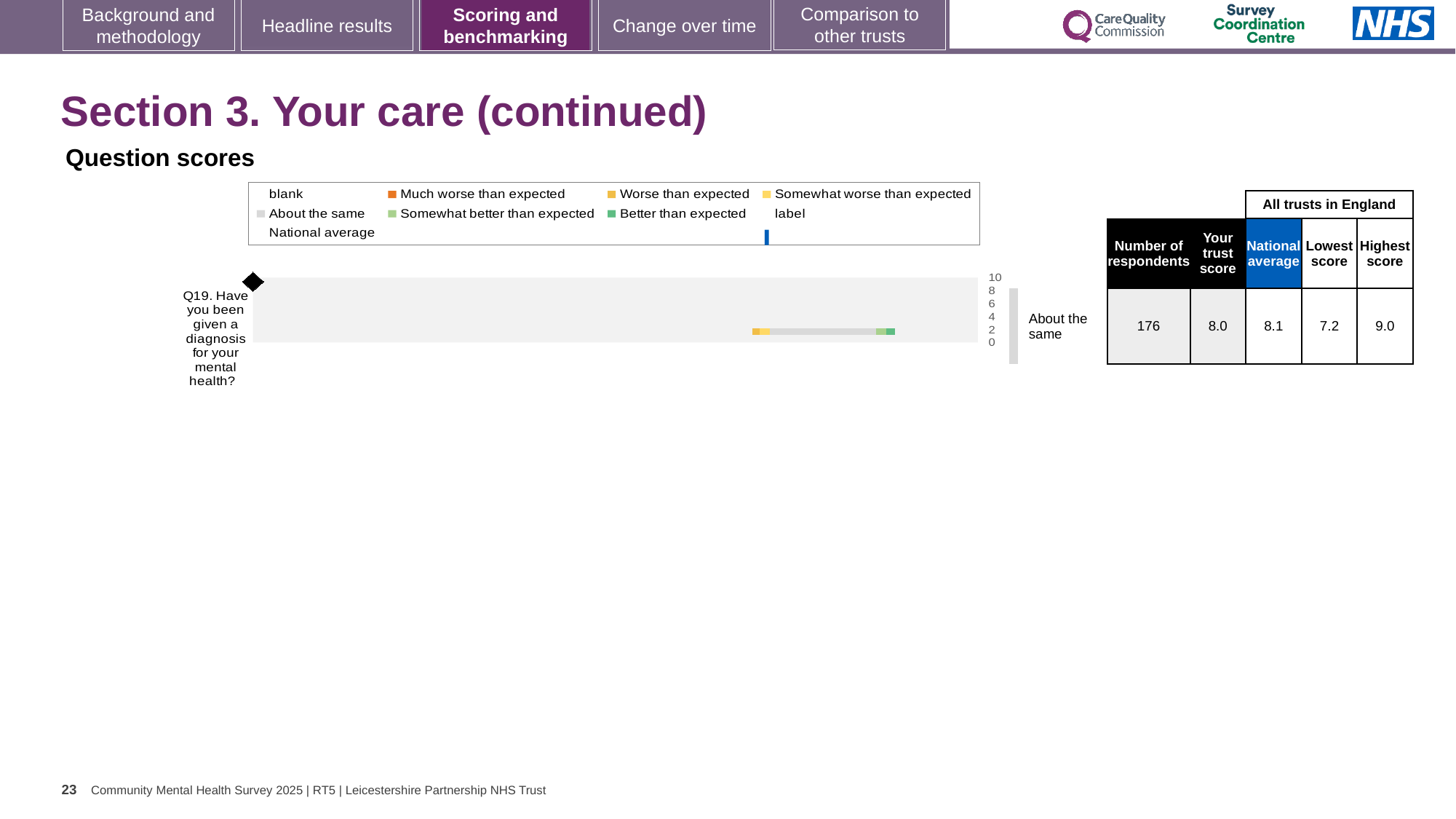
What is the number of respondents for Q19? 176 Which is larger for Q19, the trust score or the national average? national average What is the trust score for Q19? 8.0 How many questions are plotted in the Question scores chart? 1 What is the lowest score among all trusts in England for Q19? 7.2 What kind of chart is shown under "Question scores"? bar chart What is the difference between the highest and lowest scores among all trusts in England for Q19? 1.8 What is the national average for Q19? 8.1 What benchmark category is shown next to the bar for Q19? About the same What is the highest score among all trusts in England for Q19? 9.0 Which question is plotted in the Question scores chart? Q19. Have you been given a diagnosis for your mental health? What is the maximum value shown on the chart's score axis? 10